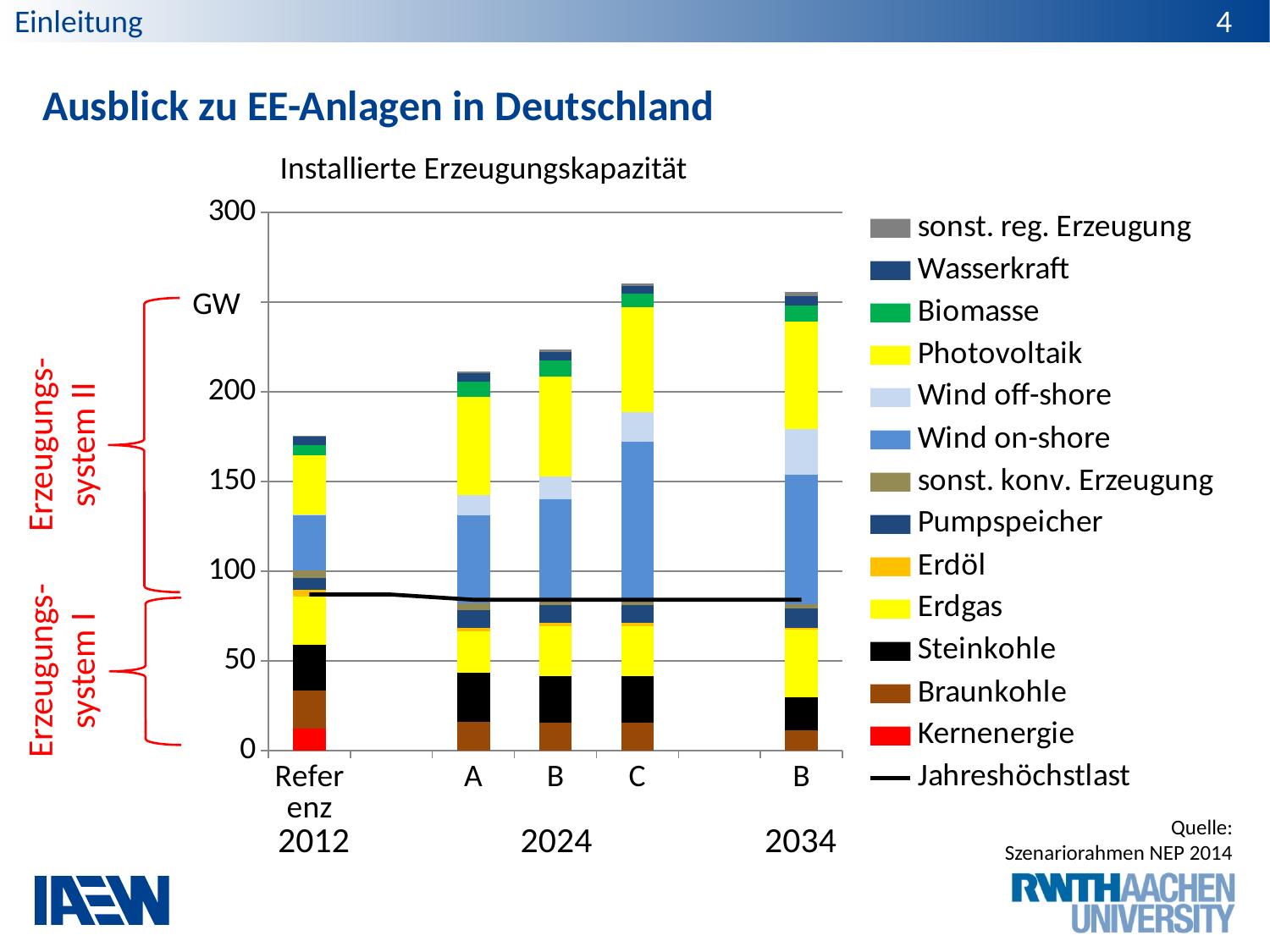
What is the title of the chart? Installierte Erzeugungskapazität Is the total installed capacity of the Referenz 2012 bar greater or less than 200 GW? less What is the unit shown on the vertical axis? GW Is the total installed capacity of scenario C 2024 greater or less than 250 GW? greater In which bar does the Kernenergie (red) segment appear? Referenz 2012 Which bar has the lowest total installed capacity? Referenz 2012 Is the total installed capacity of the Referenz 2012 bar greater or less than 150 GW? greater What kind of chart is shown on the slide? stacked bar chart with a line (combination chart) Which bar has the larger total installed capacity, Referenz 2012 or A 2024? A 2024 How many bars (scenarios) are plotted in the chart? 5 How many entries does the chart legend list? 14